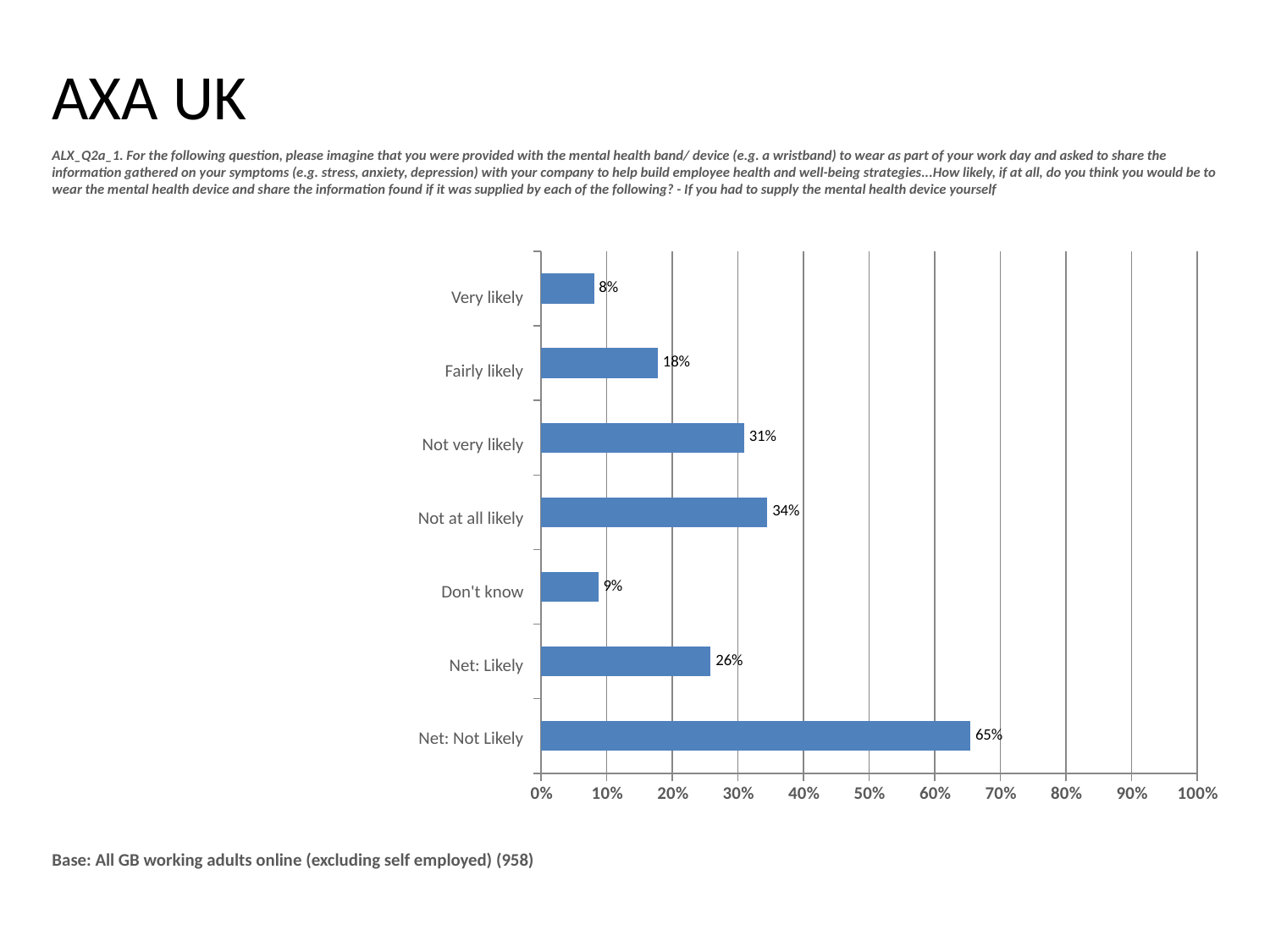
Which category has the highest value? Net: Not Likely Which category has the lowest value? Very likely What is the value for Not at all likely? 34% What is the value for Net: Not Likely? 65% What is the difference between Not very likely and Fairly likely? 13% What kind of chart is shown on the slide? Bar chart Is the value for Net: Not Likely greater or less than 60%? greater What is the difference between Net: Not Likely and Net: Likely? 39% What is the value for Don't know? 9% What is the value for Very likely? 8% Which is larger, Not at all likely or Not very likely? Not at all likely How many categories are shown on the chart? 7